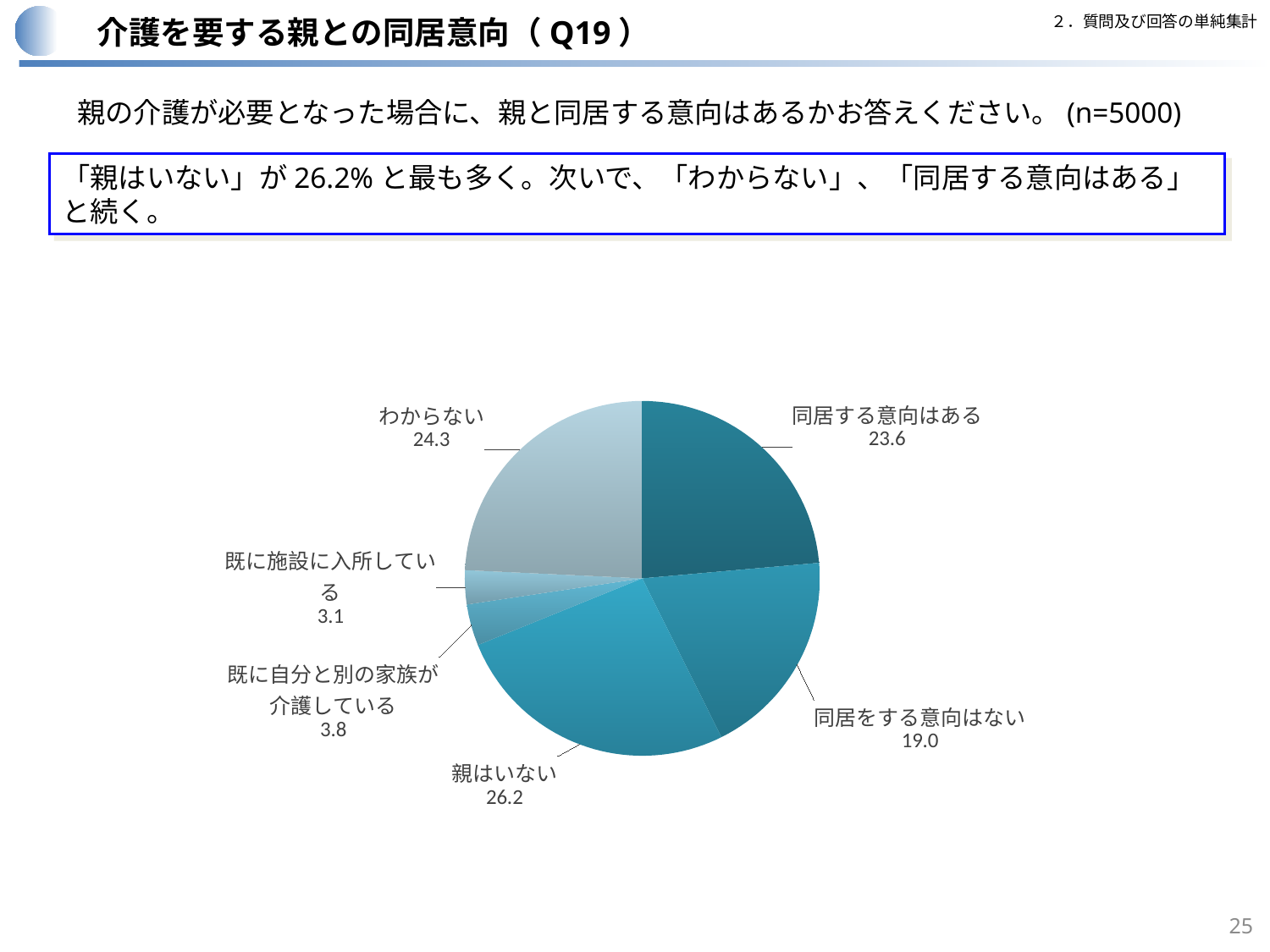
What is the value for 「親はいない」? 26.2 How many categories are shown in the pie chart? 6 What is the value for 「同居する意向はある」? 23.6 Which is larger, the value for 「既に自分と別の家族が介護している」 or 「既に施設に入所している」? 既に自分と別の家族が介護している Which category has the largest share of the pie? 親はいない Which category has the smallest share of the pie? 既に施設に入所している What is the sample size (n) stated on the slide? n=5000 What is the value for 「同居をする意向はない」? 19.0 What is the difference between the values for 「わからない」 and 「同居をする意向はない」? 5.3 What kind of chart is shown on the slide? pie chart What is the value for 「既に施設に入所している」? 3.1 What is the difference between the values for 「親はいない」 and 「同居する意向はある」? 2.6